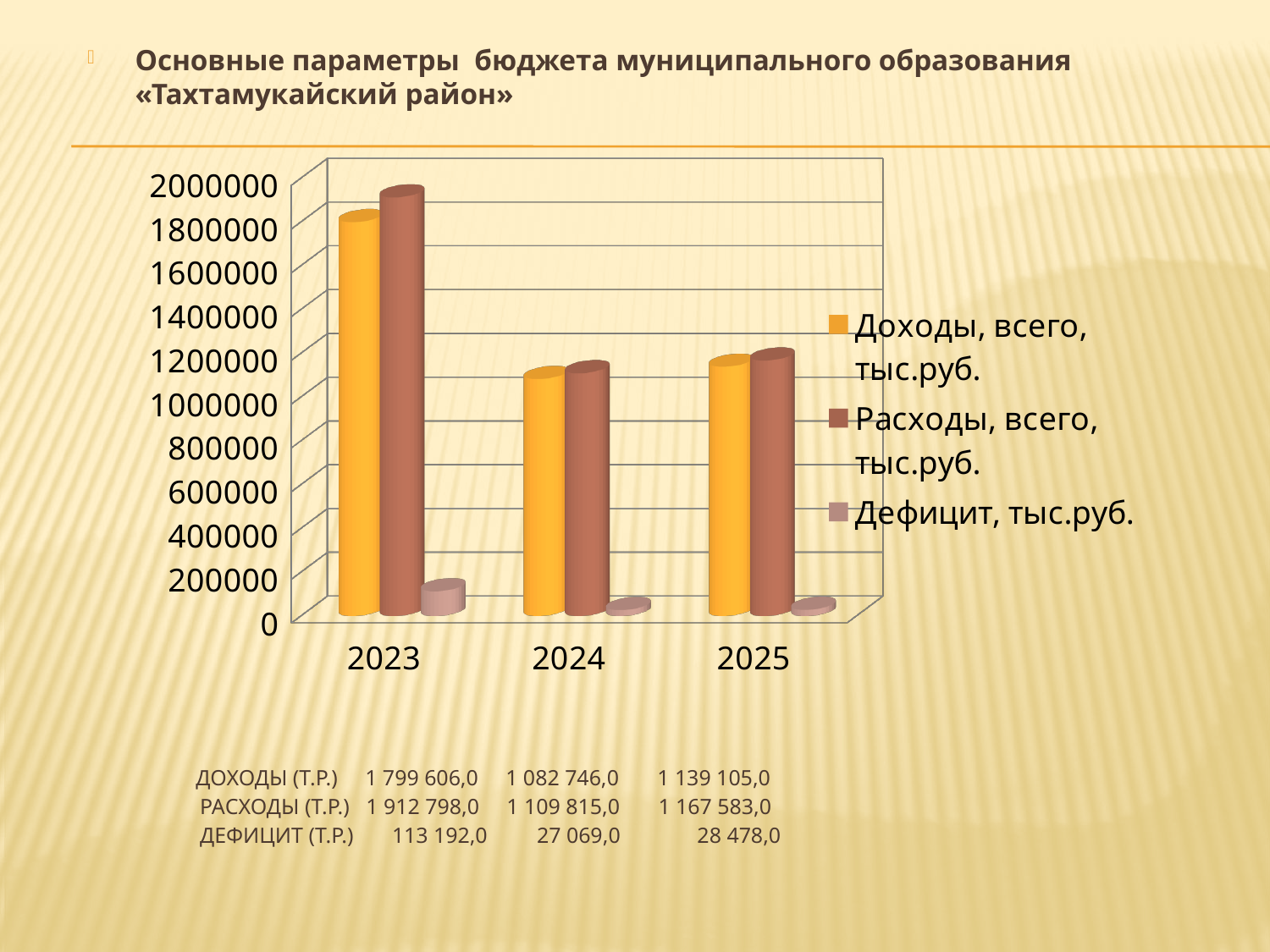
How many series does the legend list? 3 Is the value of Доходы, всего for 2025 greater or less than 1000000? greater How many years are shown on the x axis of the chart? 3 Which colour represents Дефицит, тыс.руб. in the legend? pink/light brown What is the value of Доходы (т.р.) for 2023? 1 799 606,0 What is the value of Дефицит (т.р.) for 2024? 27 069,0 What is the value of Расходы (т.р.) for 2025? 1 167 583,0 What type of chart is shown on the slide? bar chart In which year is Расходы, всего the highest? 2023 In which year is Доходы, всего the lowest? 2024 Which is larger in 2024: Доходы, всего or Расходы, всего? Расходы, всего What is the difference between Расходы and Доходы in 2023? 113 192,0